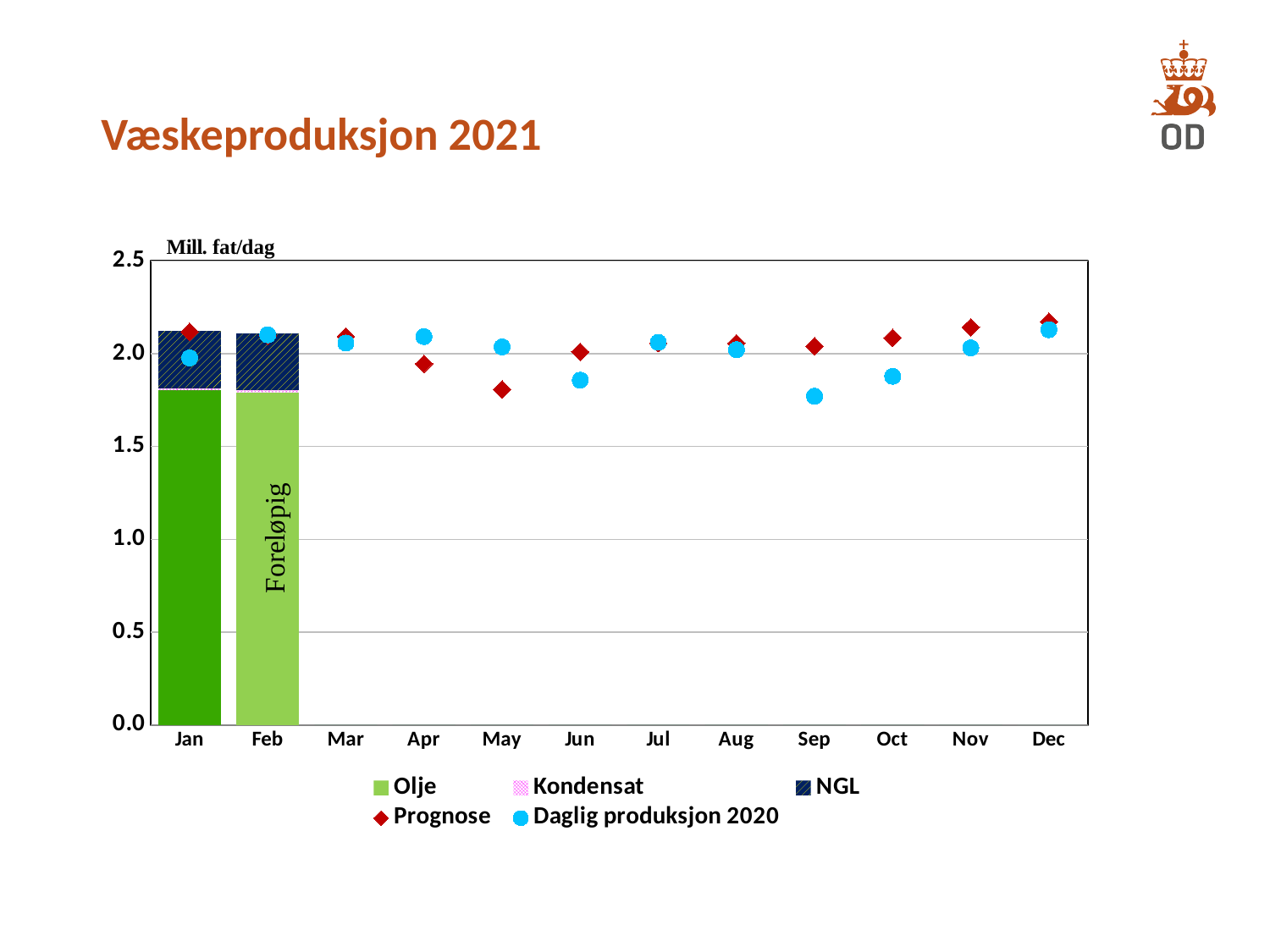
For Jun, which is larger: Prognose or Daglig produksjon 2020? Prognose How many months are shown along the x axis? 12 How many series does the legend list? 5 In which month is the Daglig produksjon 2020 value lowest? Sep Is the Prognose value for Dec greater or less than 2.0? greater What unit is shown at the top of the y axis? Mill. fat/dag Is the Prognose value for May greater or less than 2.0? less For Apr, which is larger: Prognose or Daglig produksjon 2020? Daglig produksjon 2020 In which month is the Prognose value lowest? May Is the Daglig produksjon 2020 value for Sep greater or less than 2.0? less What word is written on the Feb bar? Foreløpig